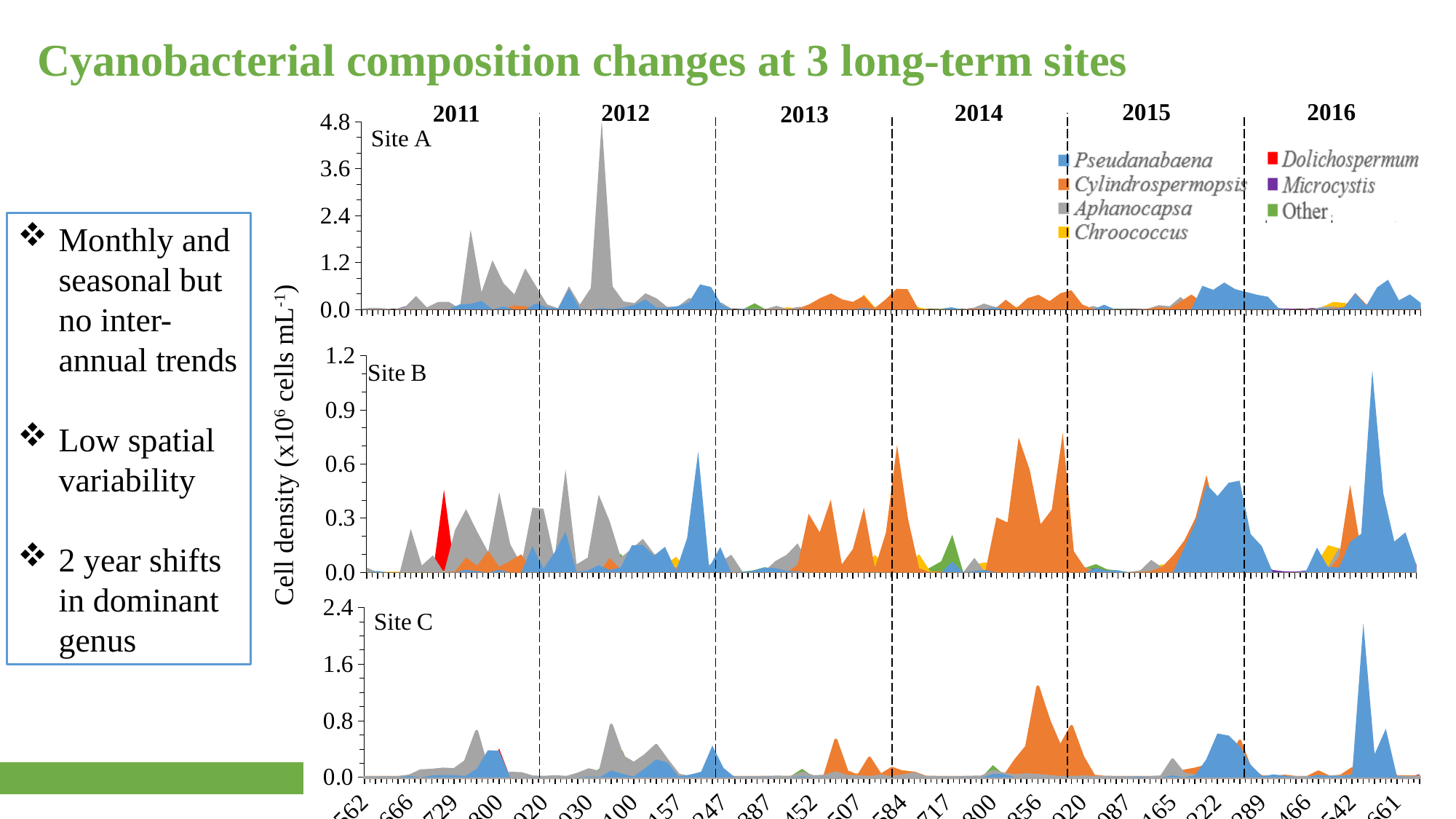
In the Site A chart, which year contains the highest peak? 2012 What is the y-axis label shared by the three charts? Cell density (x10^6 cells mL^-1) How many years are marked along the top of the charts? 6 How many genera (series) does the legend list? 7 What kind of chart is used for Site A, Site B and Site C on this slide? Area chart In the Site C chart, is the tallest peak in 2016 greater or less than 1.6? greater In the Site A chart, is the tallest peak in 2012 greater or less than 3.6? greater In the Site C chart, is the orange (Cylindrospermopsis) peak in 2014 greater or less than 1.6? less Which site chart has the largest maximum value on its y-axis? Site A How many site panels (charts) are shown on the slide? 3 Which genus is shown in blue in the legend? Pseudanabaena